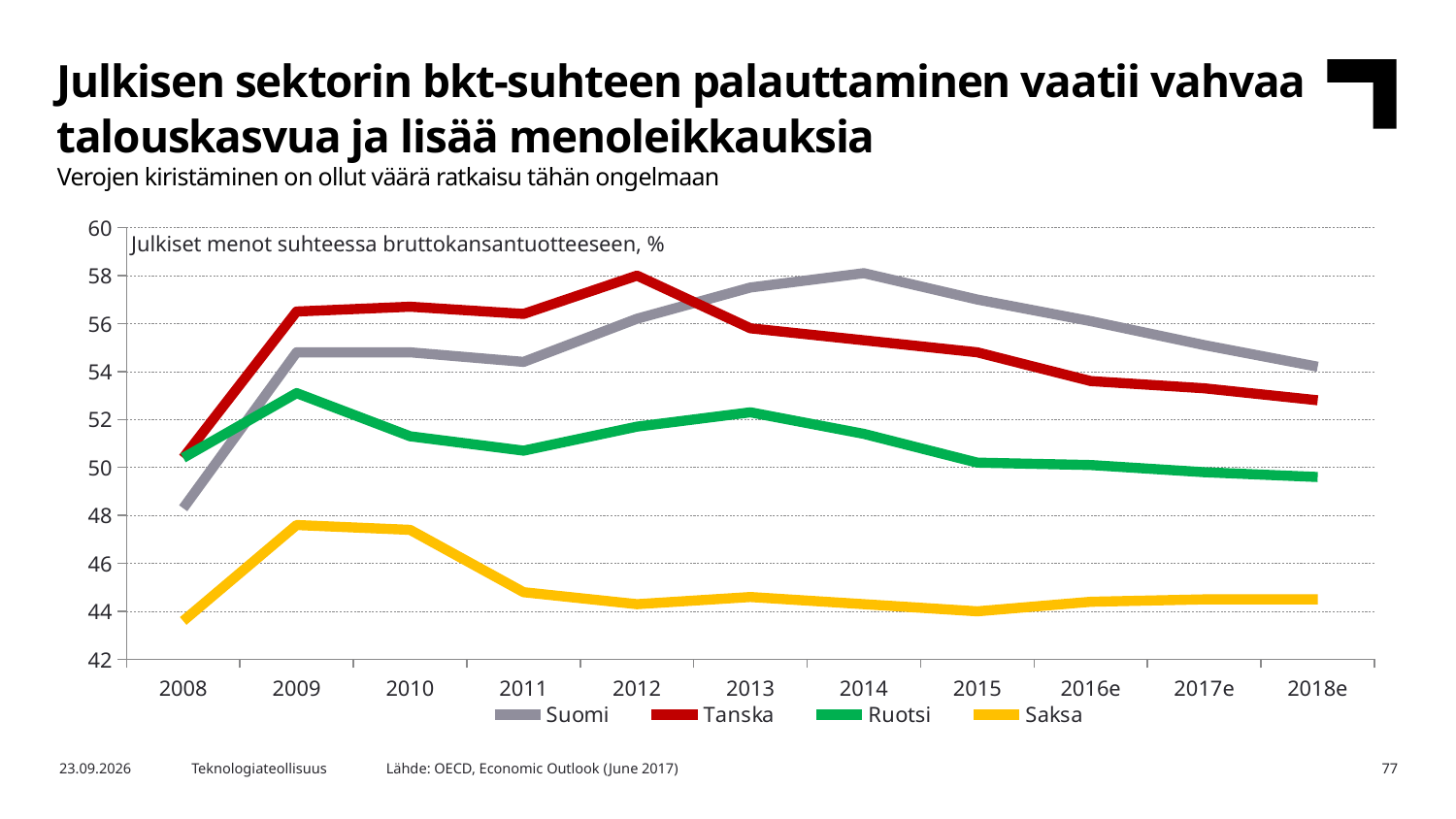
Which series has the highest value in 2014? Suomi How many years are shown on the x axis? 11 Which is larger in 2009, the value for Tanska or the value for Suomi? Tanska Which is larger in 2018e, the value for Suomi or the value for Tanska? Suomi Is the value for Tanska in 2012 greater or less than 56? greater What kind of chart is shown on the slide? line chart Is the value for Suomi in 2014 greater or less than 56? greater Is the value for Saksa in 2008 greater or less than 46? less Does the value for Suomi rise or fall from 2014 to 2018e? fall Which series has the lowest value in 2008? Saksa How many series does the legend list? 4 In which year does Tanska reach its highest value? 2012